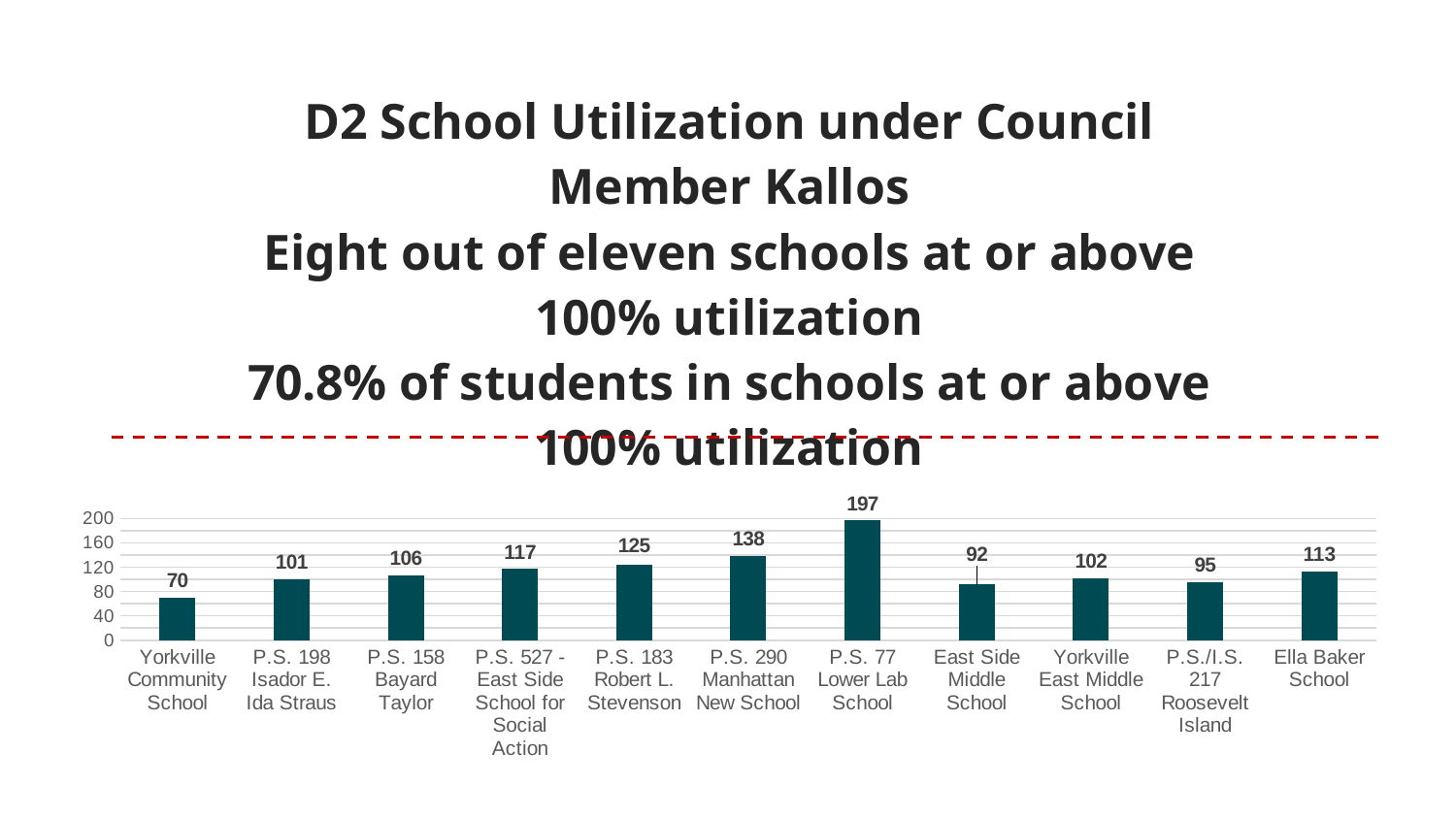
Which is larger, the value for P.S. 183 Robert L. Stevenson or the value for East Side Middle School? P.S. 183 Robert L. Stevenson Which school has the highest value? P.S. 77 Lower Lab School What is the difference between the values for P.S. 158 Bayard Taylor and P.S./I.S. 217 Roosevelt Island? 11 What kind of chart is shown on the slide? Bar chart How many schools are shown in the chart? 11 What is the value for Yorkville Community School? 70 What is the value for Ella Baker School? 113 Which school has the lowest value? Yorkville Community School What is the value for P.S. 290 Manhattan New School? 138 What is the value for P.S. 77 Lower Lab School? 197 What is the difference between the values for P.S. 77 Lower Lab School and Yorkville Community School? 127 Is the value for P.S. 527 - East Side School for Social Action greater or less than 80? greater